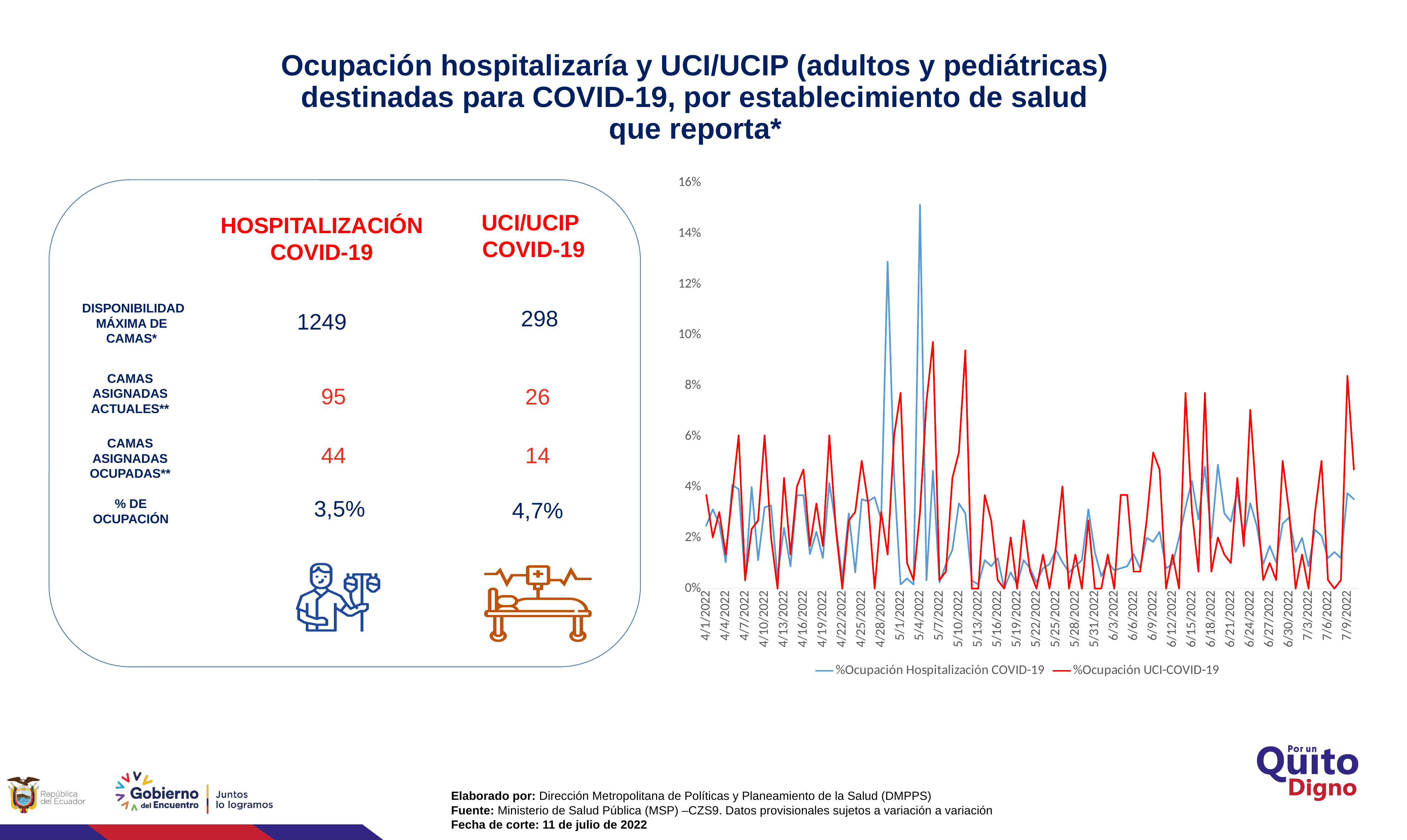
In the line chart, is the highest peak of the %Ocupación Hospitalización COVID-19 series greater or less than 14%? greater How many date labels are shown on the x axis of the line chart? 34 In the line chart, is the value of the %Ocupación Hospitalización COVID-19 series at 5/16/2022 greater or less than 2%? less In the line chart, which colour is used for the %Ocupación UCI-COVID-19 series? red In the line chart, is the highest peak of the %Ocupación UCI-COVID-19 series greater or less than 12%? less In the line chart, which series reaches the higher maximum value, %Ocupación Hospitalización COVID-19 or %Ocupación UCI-COVID-19? %Ocupación Hospitalización COVID-19 What kind of chart is shown on the right side of the slide? line chart What are the two series named in the legend of the line chart? %Ocupación Hospitalización COVID-19 and %Ocupación UCI-COVID-19 How many series does the legend of the line chart list? 2